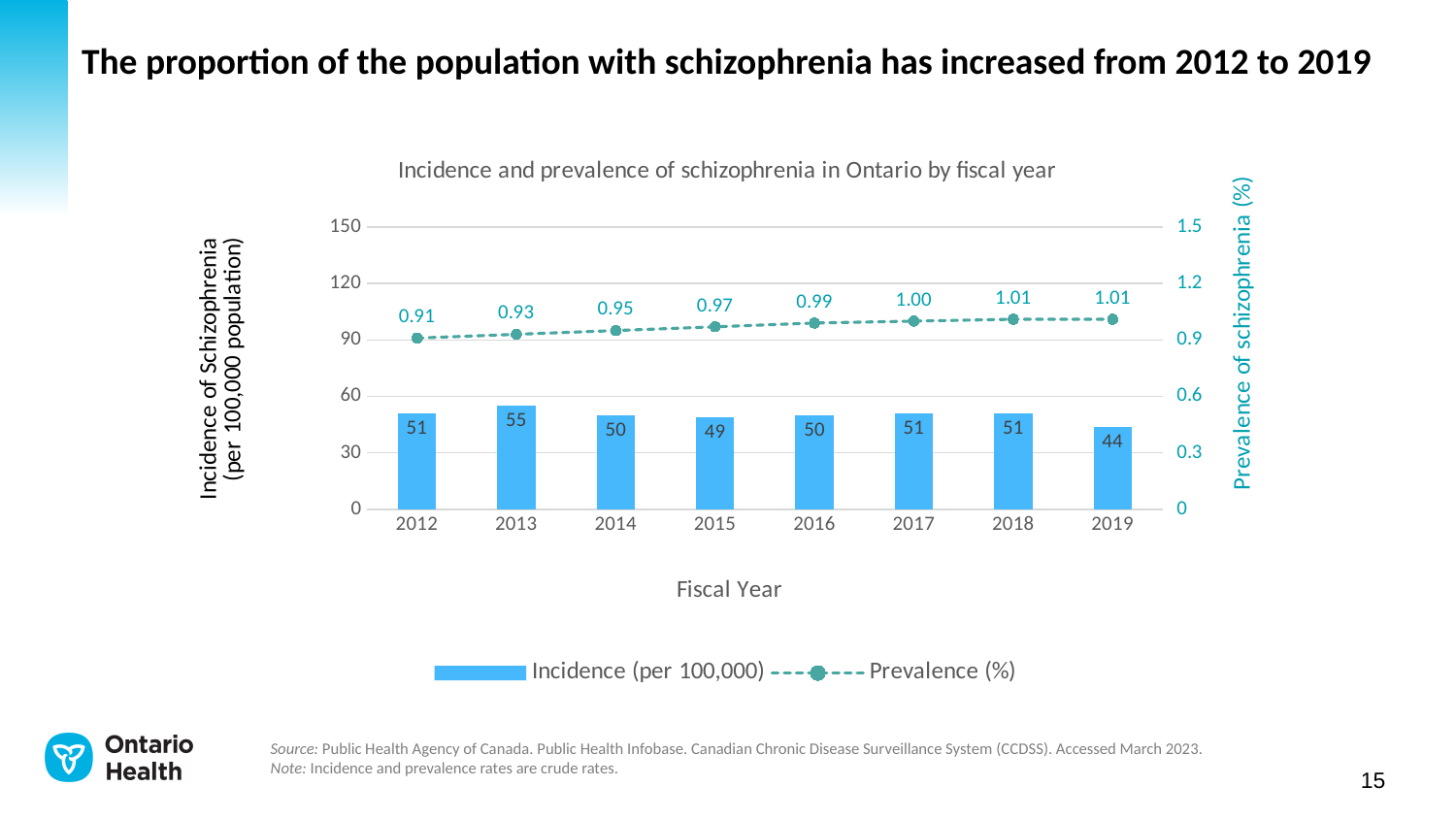
Is the incidence value for 2019 greater or less than 60? less Which fiscal year has the lowest incidence of schizophrenia? 2019 Which fiscal year has the lowest prevalence of schizophrenia? 2012 What is the title of the chart? Incidence and prevalence of schizophrenia in Ontario by fiscal year Which fiscal year has the highest incidence of schizophrenia? 2013 Is the incidence higher in 2015 or in 2017? 2017 Does the prevalence of schizophrenia rise or fall from 2012 to 2019? rise What is the incidence of schizophrenia (per 100,000) in 2013? 55 What is the difference in incidence between 2013 and 2019? 11 How many fiscal years are shown on the x axis? 8 How many series does the legend list? 2 What is the prevalence of schizophrenia (%) in 2016? 0.99